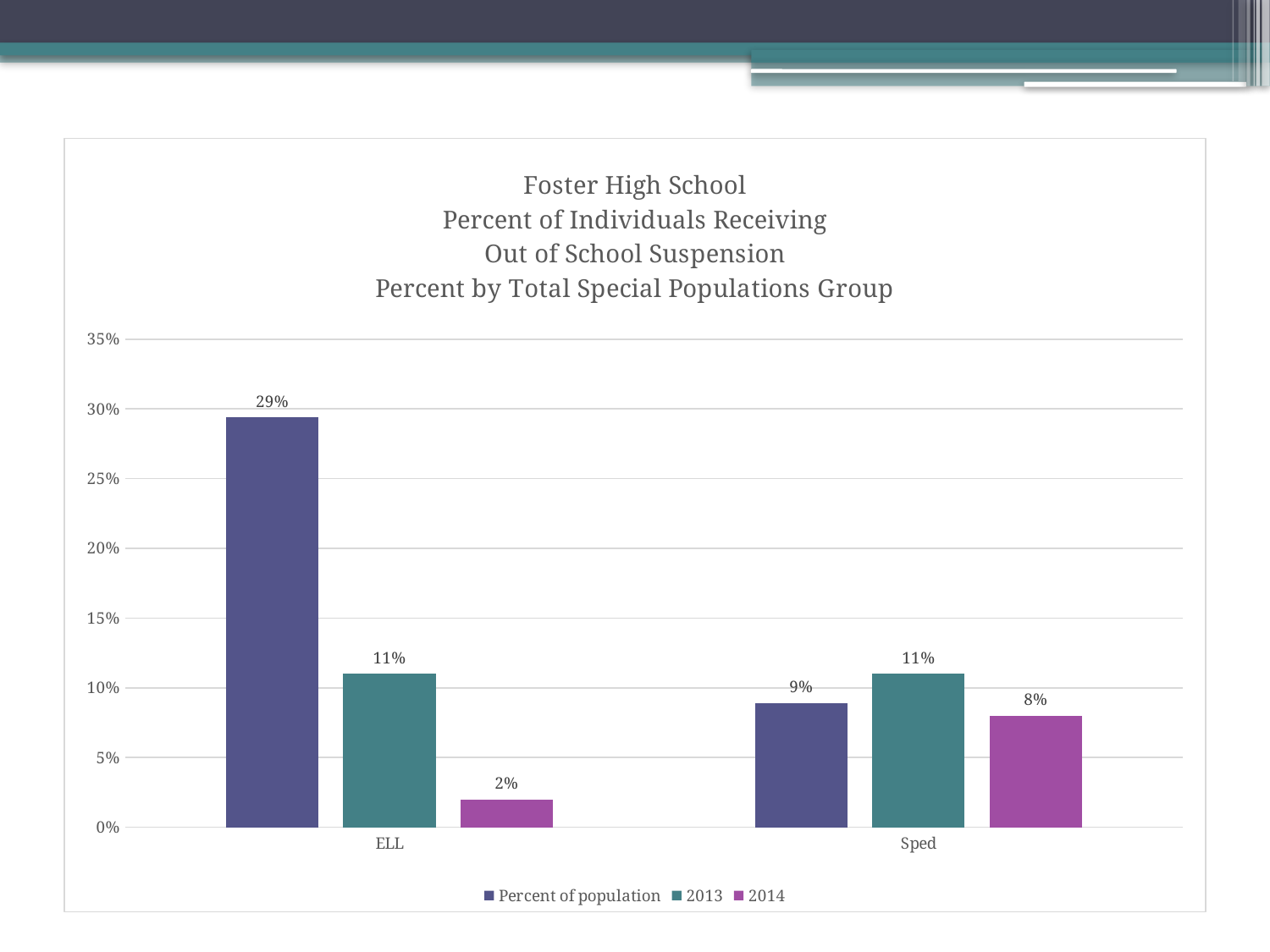
What is the 2014 value for ELL? 2% What kind of chart is shown on the slide? bar chart Which category has the highest Percent of population value? ELL Which category has the lowest 2014 value? ELL How many categories are shown on the x axis? 2 How many series does the legend list? 3 Is the Percent of population value for ELL greater or less than 25%? greater What is the 2014 value for Sped? 8% What is the difference between the Percent of population value for ELL and for Sped? 20% Which is larger, the 2013 value for Sped or the 2014 value for Sped? 2013 What is the Percent of population value for ELL? 29% What is the 2013 value for ELL? 11%